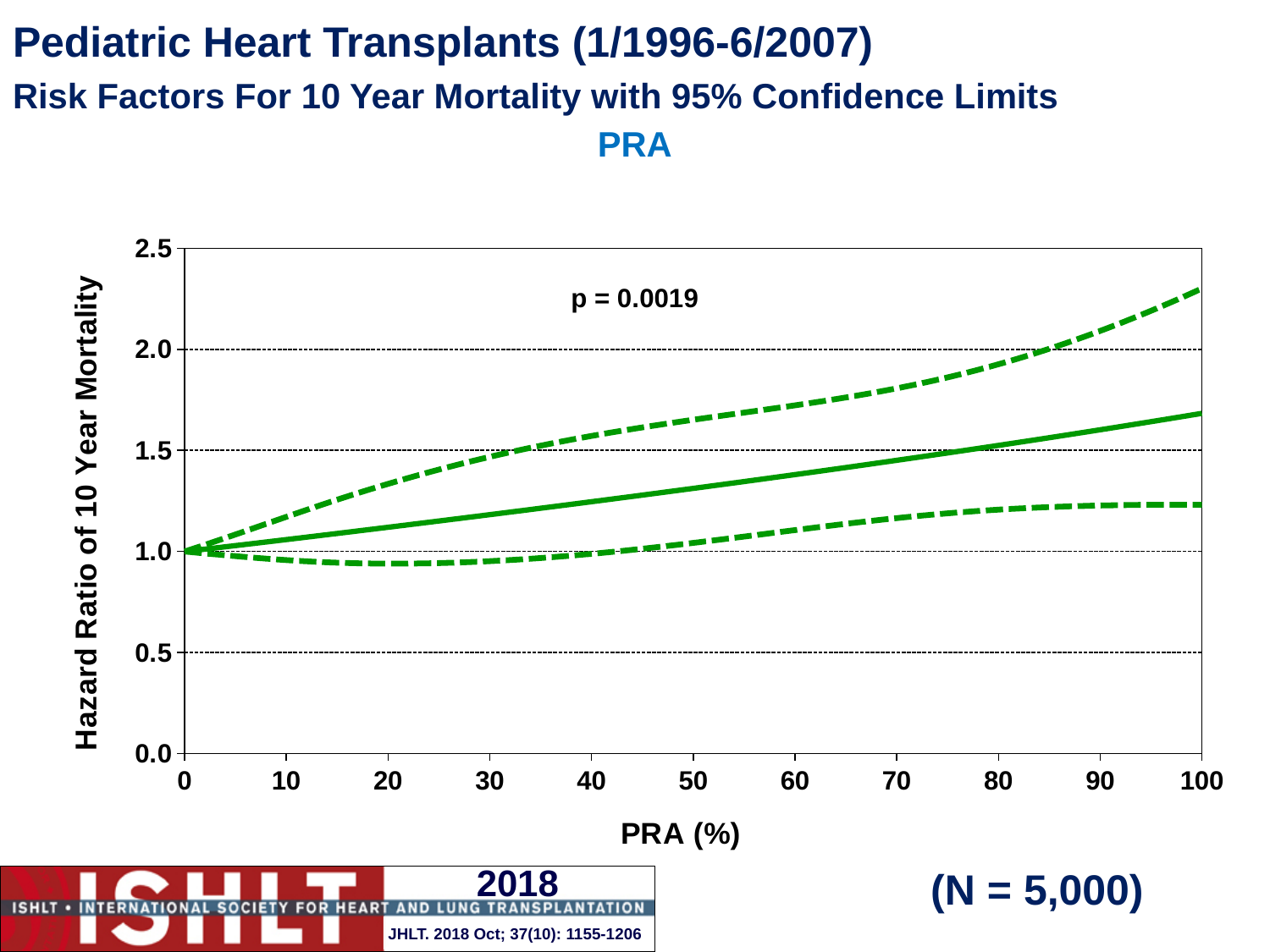
Is the upper dashed confidence limit at a PRA of 100% greater or less than 2.0? greater What kind of chart is shown on the slide? line chart What p-value is printed on the chart? p = 0.0019 Is the lower dashed confidence limit at a PRA of 100% greater or less than 1.5? less What is the label of the y axis? Hazard Ratio of 10 Year Mortality Does the solid hazard ratio line rise or fall as PRA (%) increases from 0 to 100? rise How many lines are plotted on the chart? 3 Is the hazard ratio on the solid line at a PRA of 100% greater or less than 1.5? greater What is the hazard ratio of 10 year mortality at a PRA of 0%? 1.0